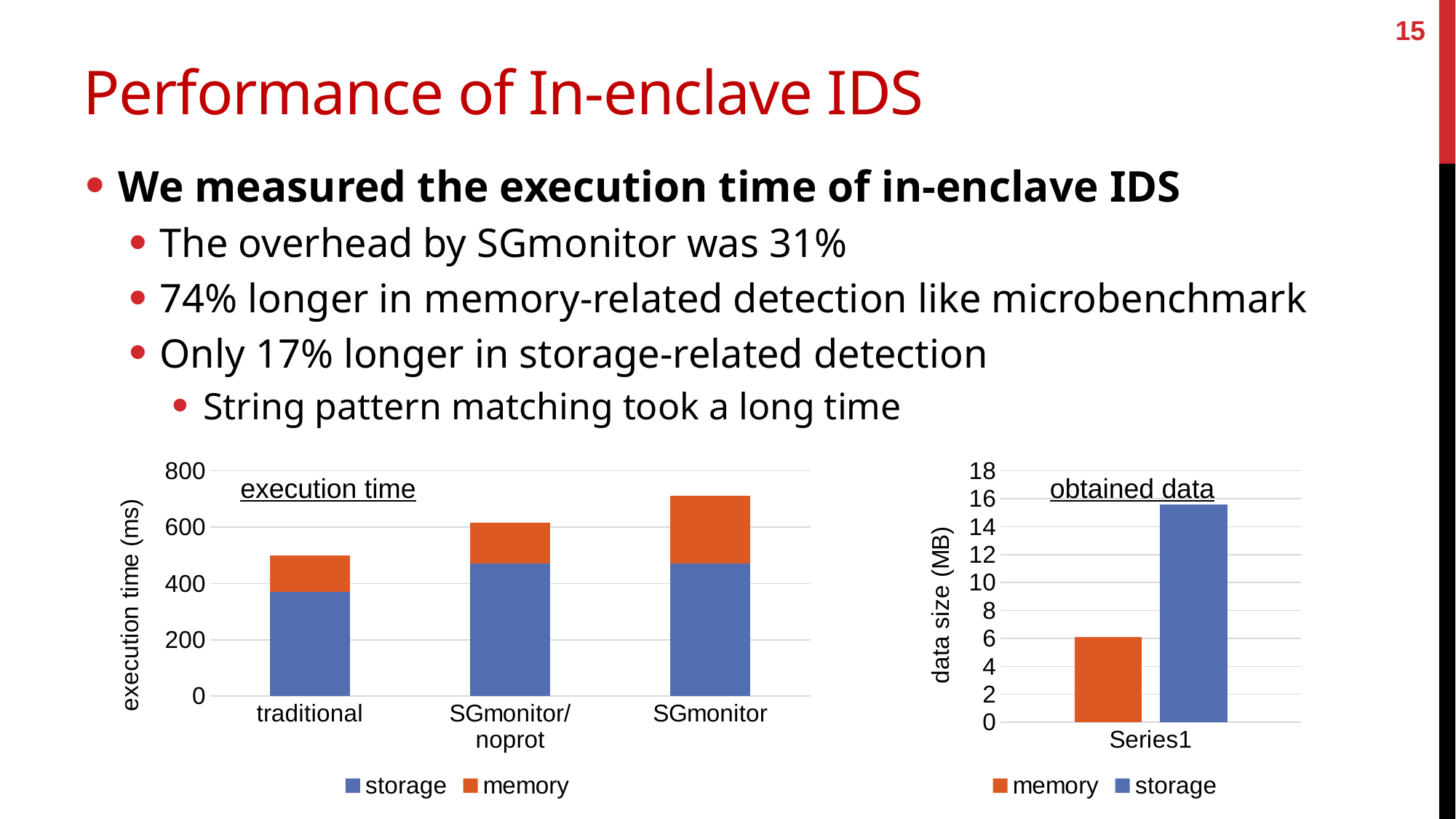
In the "execution time" chart, is the storage value for traditional greater or less than 400? less How many series does the legend of the "execution time" chart list? 2 In the "execution time" chart, do the total stacked bar heights rise or fall from traditional to SGmonitor? rise How many categories are shown on the x axis of the "execution time" chart? 3 In the "execution time" chart, is the total stacked value for SGmonitor greater or less than 600? greater What is the y-axis label of the "obtained data" chart? data size (MB) In the "execution time" chart, which series is shown in orange? memory In the "obtained data" chart, which series has the larger value, memory or storage? storage What kind of chart is the "execution time" chart? stacked bar chart In the "obtained data" chart, is the storage value greater or less than 14? greater In the "execution time" chart, which category has the shortest stacked bar? traditional In the "execution time" chart, which category has the tallest stacked bar? SGmonitor